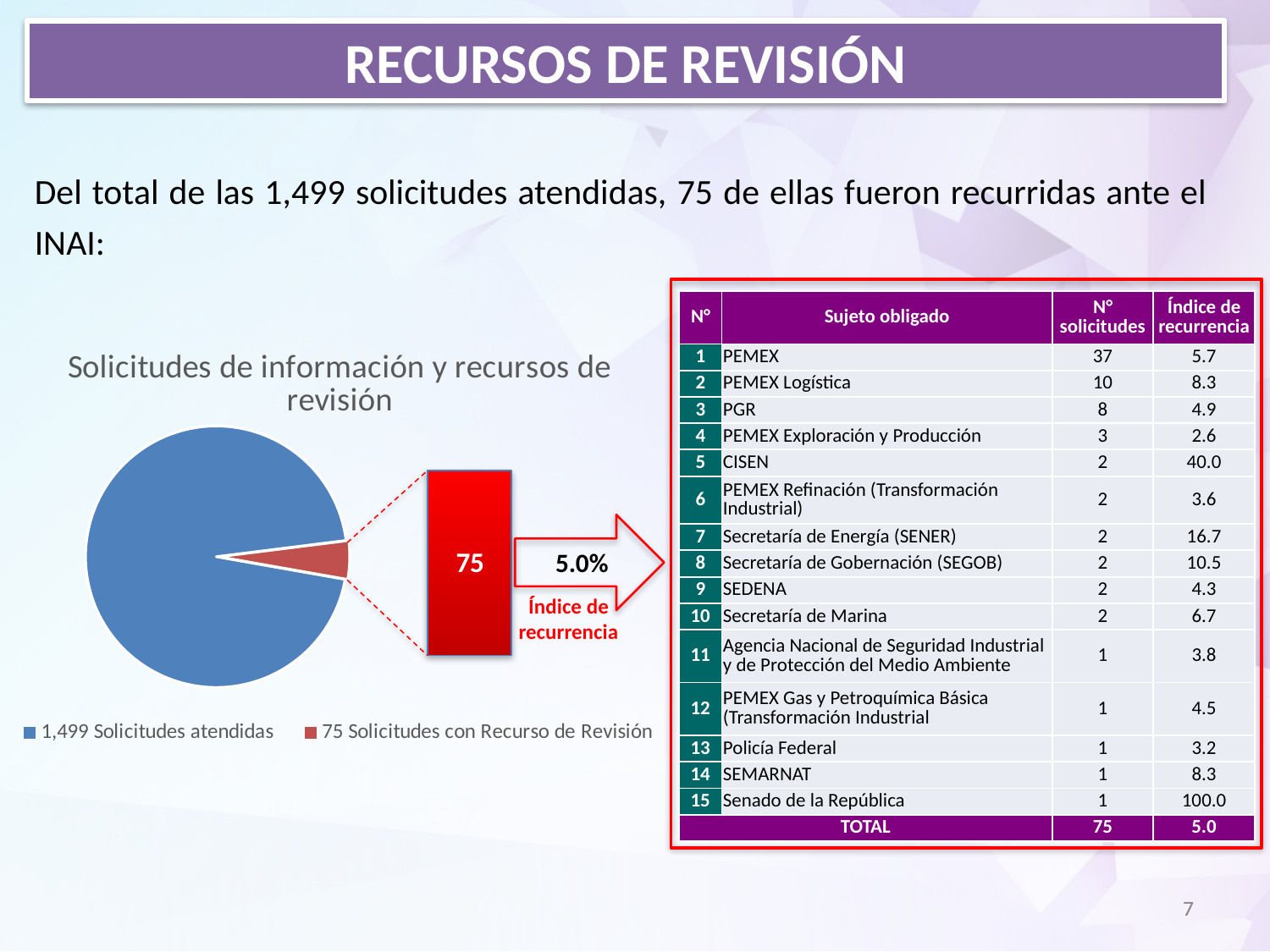
What is the title of the pie chart? Solicitudes de información y recursos de revisión What is the value for Solicitudes atendidas in the pie chart? 1,499 What Índice de recurrencia percentage is shown in the callout next to the 75 slice of the pie chart? 5.0% Which slice of the pie chart is the largest? 1,499 Solicitudes atendidas What is the difference between the Solicitudes atendidas value and the Solicitudes con Recurso de Revisión value in the pie chart? 1,424 What colour is the Solicitudes con Recurso de Revisión slice in the pie chart? red What kind of chart is shown on the slide? pie chart Which slice of the pie chart is the smallest? 75 Solicitudes con Recurso de Revisión How many slices does the pie chart have? 2 How many entries does the pie chart's legend list? 2 What is the value for Solicitudes con Recurso de Revisión in the pie chart? 75 Which is larger in the pie chart, Solicitudes atendidas or Solicitudes con Recurso de Revisión? Solicitudes atendidas